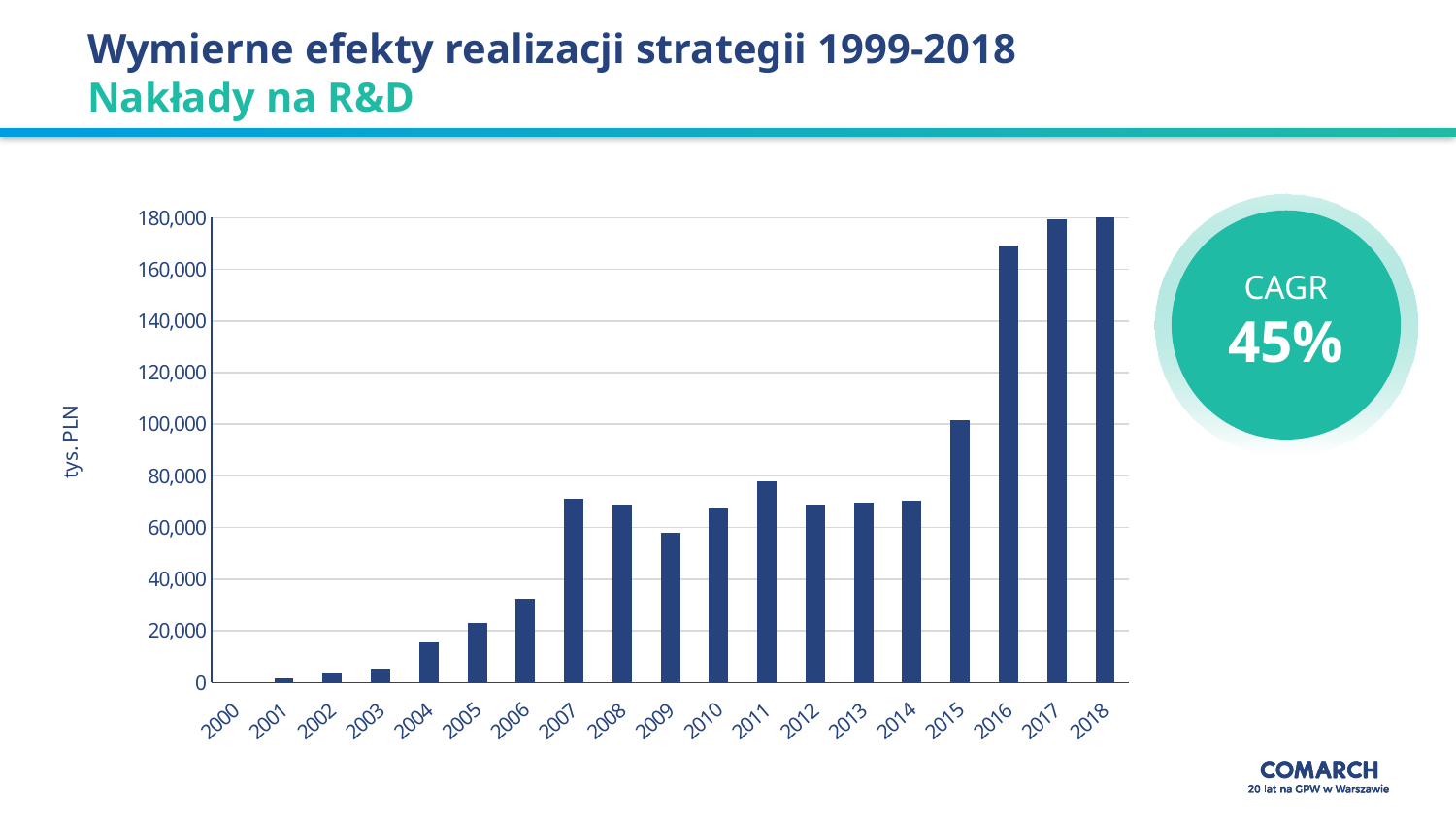
Is the value for 2009 greater or less than 60,000? less Which year has the larger value, 2009 or 2010? 2010 Is the value for 2016 greater or less than 160,000? greater Which year has the lowest R&D expenditure in the chart? 2000 Is the value for 2011 greater or less than 70,000? greater What unit is shown on the y axis label of the chart? tys. PLN Do the values generally rise or fall from 2000 to 2018? rise What type of chart is shown on the slide? bar chart Which year has the larger value, 2014 or 2015? 2015 How many years are shown on the x axis of the chart? 19